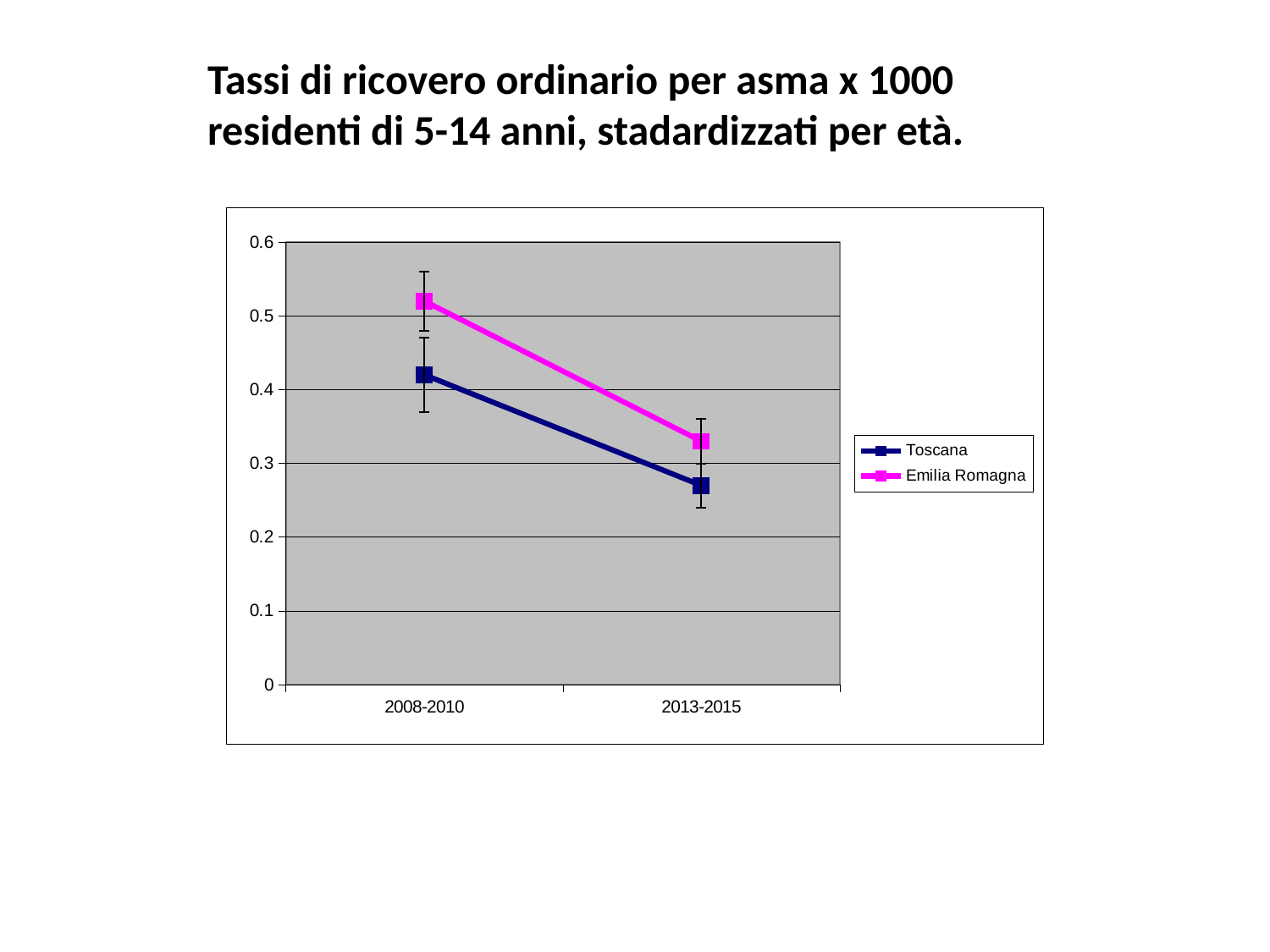
Is the value for Emilia Romagna in 2008-2010 greater or less than 0.4? greater Does the Toscana series rise or fall from 2008-2010 to 2013-2015? fall Which series has the higher value in 2013-2015, Toscana or Emilia Romagna? Emilia Romagna Is the value for Emilia Romagna in 2013-2015 greater or less than 0.3? greater Does the Emilia Romagna series rise or fall from 2008-2010 to 2013-2015? fall Is the value for Toscana in 2013-2015 greater or less than 0.3? less How many periods are shown on the x axis? 2 How many series does the legend list? 2 Which series has the higher value in 2008-2010, Toscana or Emilia Romagna? Emilia Romagna What kind of chart is shown on the slide? line chart What colour is the Emilia Romagna line in the chart? magenta (pink)